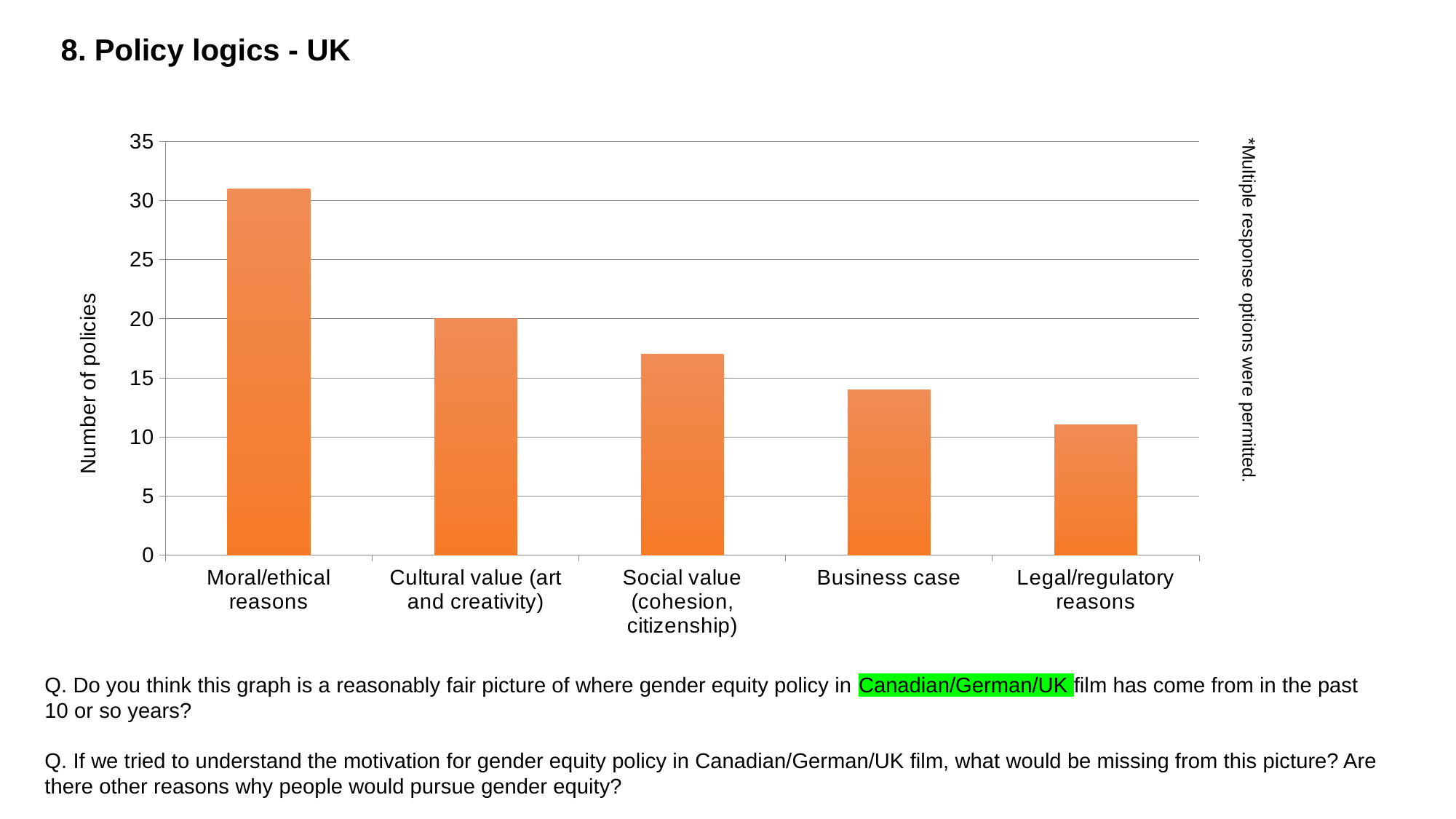
Which category has the lowest number of policies? Legal/regulatory reasons Which is larger, the value for Moral/ethical reasons or the value for Business case? Moral/ethical reasons How many categories are plotted on the chart? 5 What is the number of policies for Cultural value (art and creativity)? 20 What kind of chart is shown on the slide? bar chart Is the value for Moral/ethical reasons greater or less than 30? greater Do the values rise or fall moving from left to right along the x axis? fall Is the value for Social value (cohesion, citizenship) greater or less than 15? greater What is the label on the vertical axis of the chart? Number of policies Is the value for Legal/regulatory reasons greater or less than 10? greater Which category has the highest number of policies? Moral/ethical reasons